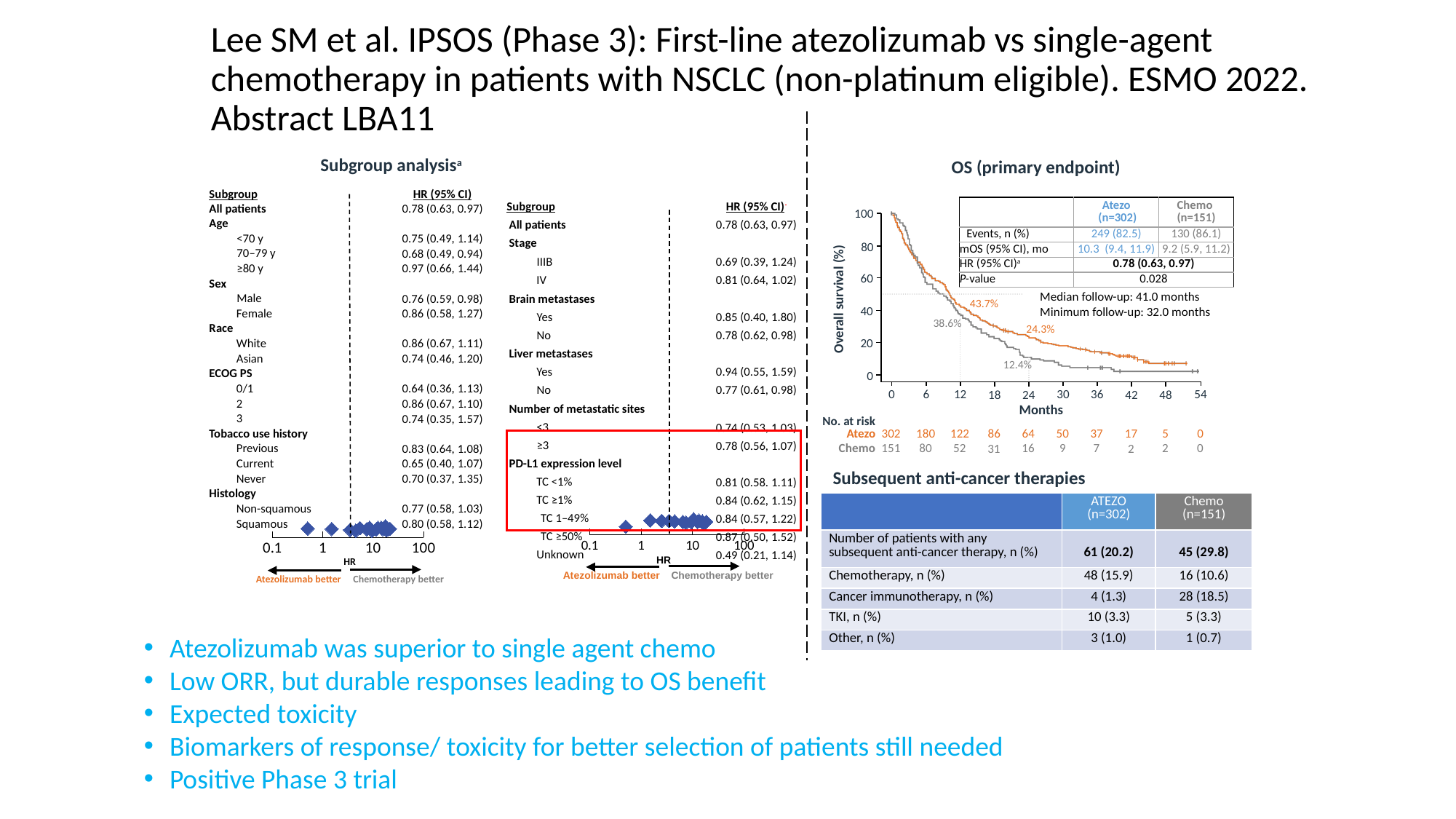
In the OS (primary endpoint) chart, what is the HR (95% CI) reported in the inset table? 0.78 (0.63, 0.97) In the OS (primary endpoint) chart, what is the labelled survival percentage for the Chemo arm at 24 months? 12.4% In the right Subgroup analysis forest plot, what is the HR (95% CI) for patients with liver metastases (Yes)? 0.94 (0.55, 1.59) In the OS (primary endpoint) chart, what is the median OS for the Atezo arm in months? 10.3 In the OS (primary endpoint) chart, which arm has the higher labelled survival percentage at 12 months, Atezo or Chemo? Atezo In the left Subgroup analysis forest plot, what is the HR (95% CI) for the Squamous histology subgroup? 0.80 (0.58, 1.12) In the OS (primary endpoint) chart, how many Atezo patients were at risk at 24 months? 64 In the OS (primary endpoint) chart, what is the labelled overall survival percentage for the Chemo arm at 12 months? 38.6% In the OS (primary endpoint) chart, what kind of chart is shown? Kaplan-Meier survival curve In the OS (primary endpoint) chart, what is the difference between the labelled 24-month survival percentages of the Atezo and Chemo arms? 11.9% In the OS (primary endpoint) chart, do the survival curves rise or fall as months increase? fall In the OS (primary endpoint) chart, what is the labelled overall survival percentage for the Atezo arm at 12 months? 43.7%